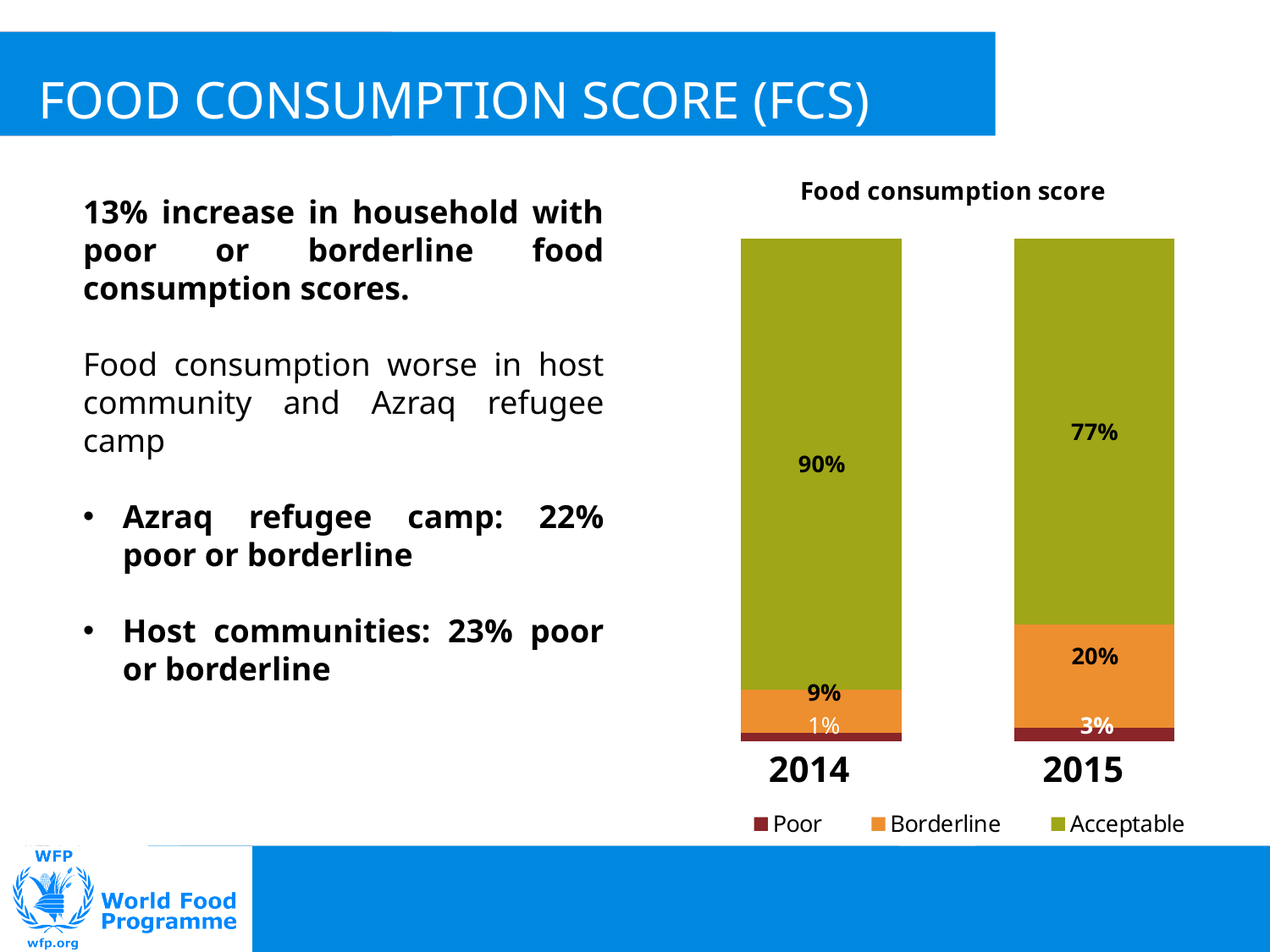
What is the title of the chart? Food consumption score What is the Acceptable share in 2014? 90% What is the difference between the Borderline shares in 2015 and 2014? 11% Which category has the smallest share in 2015? Poor What is the Poor share in 2015? 3% What kind of chart is shown? Stacked bar chart How many series does the legend list? 3 Which year has the higher Acceptable share? 2014 By how many percentage points did the Acceptable share fall from 2014 to 2015? 13% How many years are shown on the x axis? 2 What is the Poor share in 2014? 1% What is the Borderline share in 2015? 20%